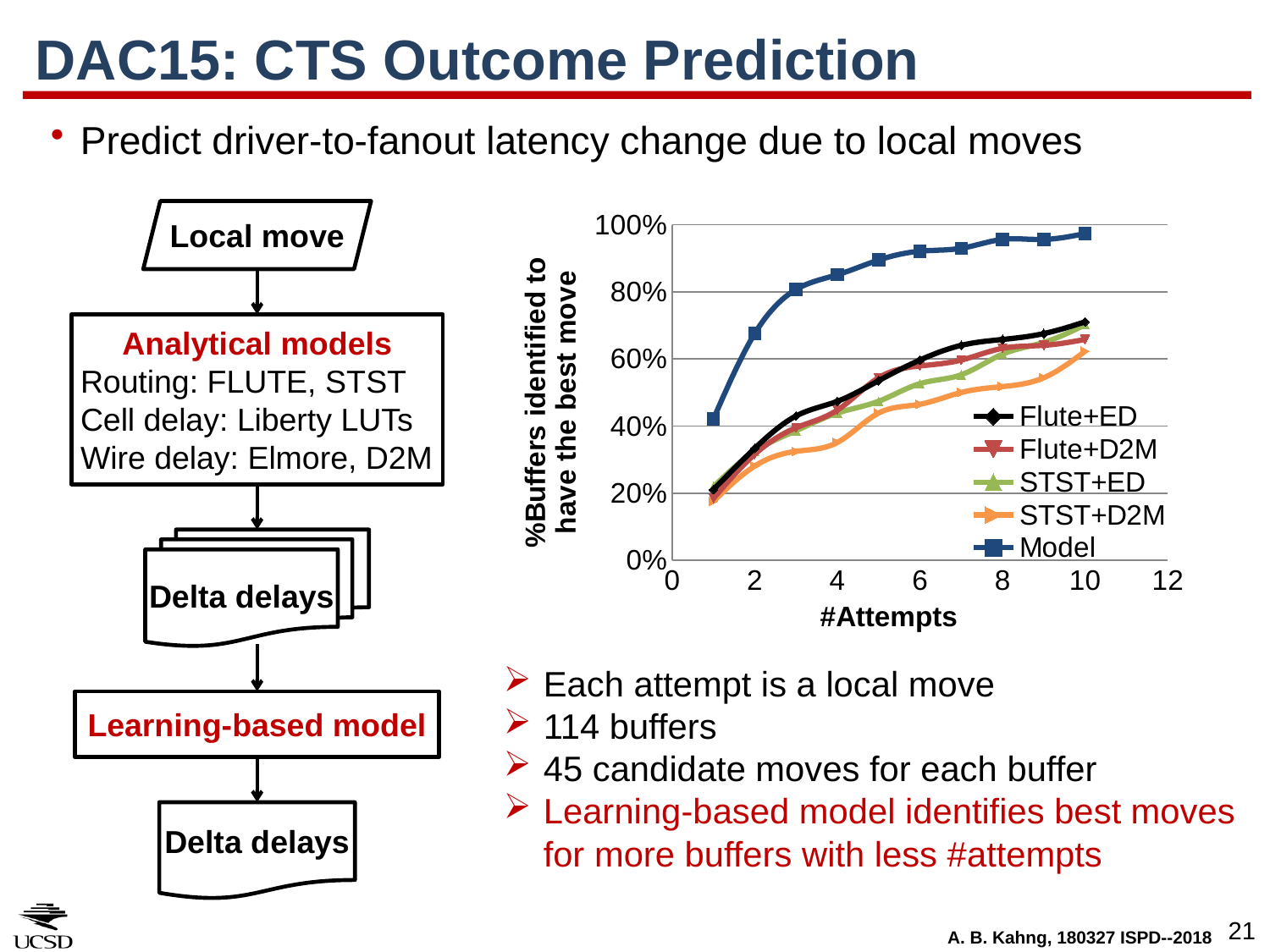
What kind of chart is shown on the slide? line chart Which series has the lowest value at 10 attempts? STST+D2M Do the values for the Model series rise or fall as the number of attempts increases? rise What is the label of the x axis of the chart? #Attempts Is the value for Flute+ED at 10 attempts greater or less than 60%? greater Which series has the highest value at 1 attempt? Model Is the value for Model at 2 attempts greater or less than 60%? greater Which series has the highest value at 10 attempts? Model Is the value for Model at 10 attempts greater or less than 80%? greater How many series does the chart legend list? 5 At 5 attempts, which is larger: the value for Model or the value for Flute+ED? Model